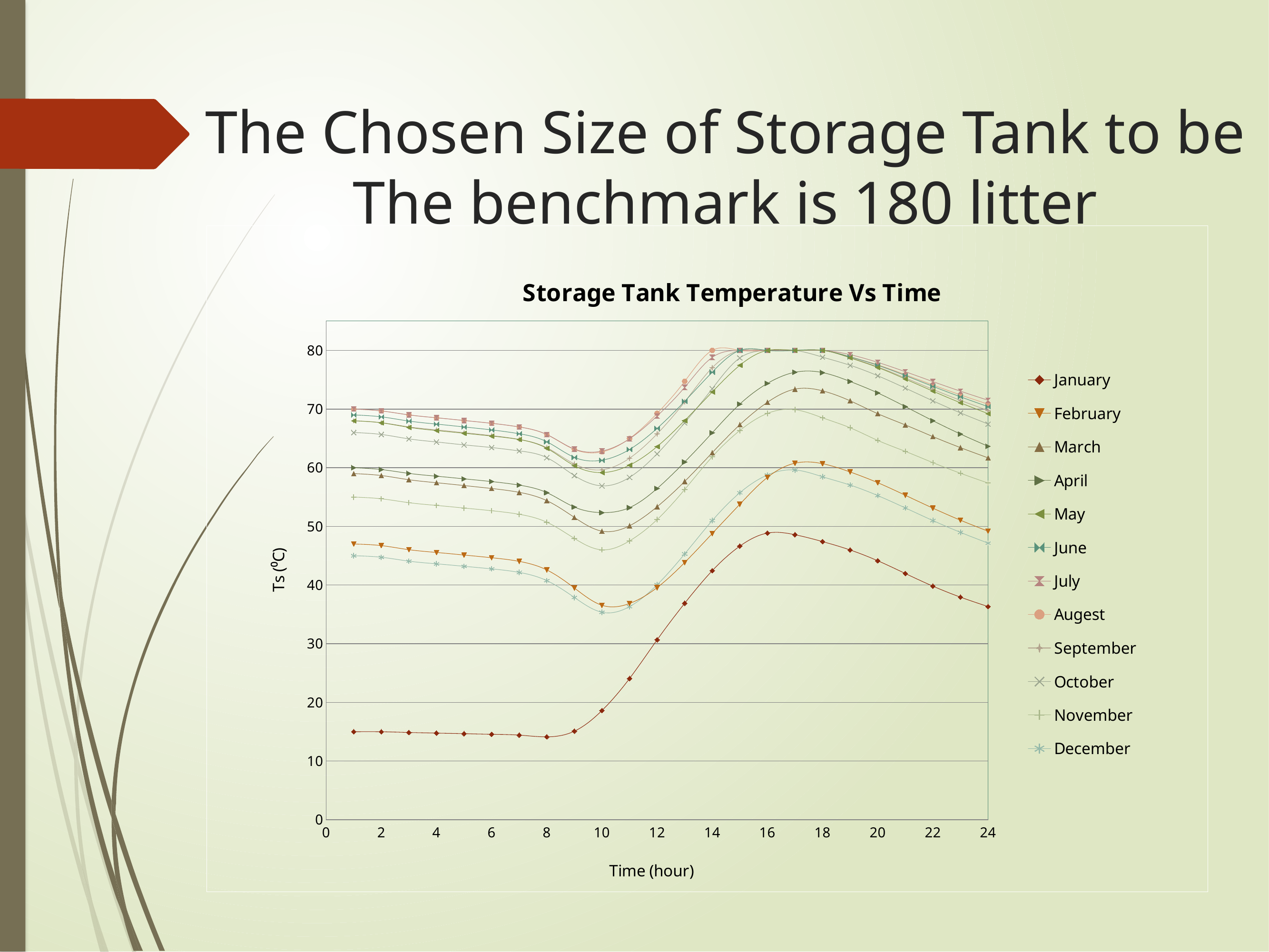
Which series has the lowest value at hour 1? January At hour 4, which is larger, the value for January or the value for February? February Does the January series rise or fall between hour 10 and hour 16? rise What is the title of the chart? Storage Tank Temperature Vs Time How many series does the legend list? 12 What is the label of the x axis? Time (hour) Is the value for November at hour 10 greater or less than 50? less Is the value for February at hour 10 greater or less than 40? less What kind of chart is shown on the slide? line chart Is the value for December at hour 1 greater or less than 40? greater